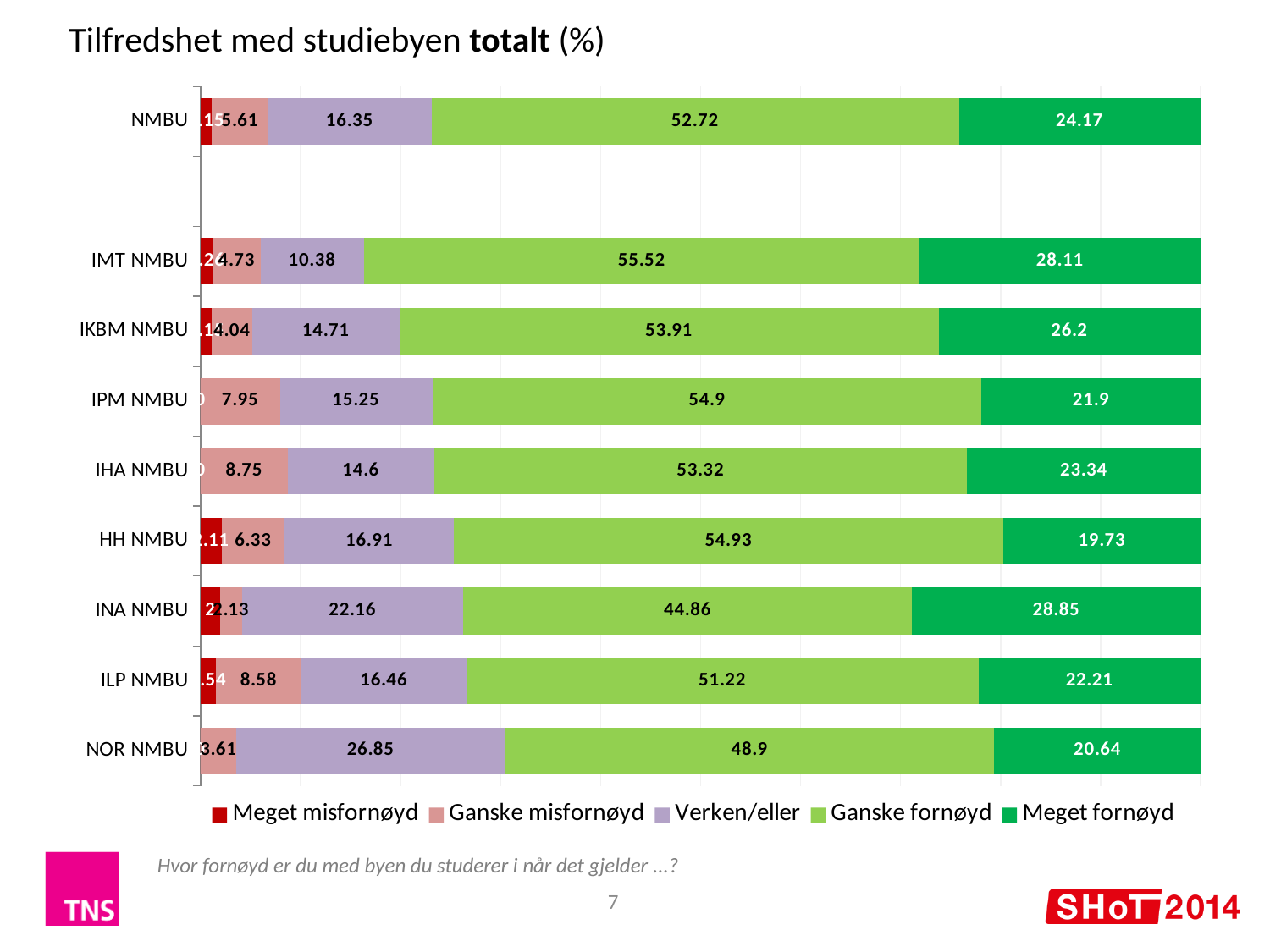
What is the 'Meget fornøyd' value for IMT NMBU? 28.11 What is the 'Verken/eller' value for NOR NMBU? 26.85 Which is larger, the 'Verken/eller' value for INA NMBU or for HH NMBU? INA NMBU What is the 'Ganske misfornøyd' value for IHA NMBU? 8.75 What type of chart is shown on the slide? stacked bar chart What is the 'Ganske fornøyd' value for NMBU? 52.72 What is the difference between the 'Meget fornøyd' values for IKBM NMBU and NOR NMBU? 5.56 How many series does the legend list? 5 Which category has the highest 'Meget fornøyd' value? INA NMBU Which category has the lowest 'Ganske fornøyd' value? INA NMBU Which legend entry is shown in dark green? Meget fornøyd How many categories (institutions) are shown on the y axis? 9